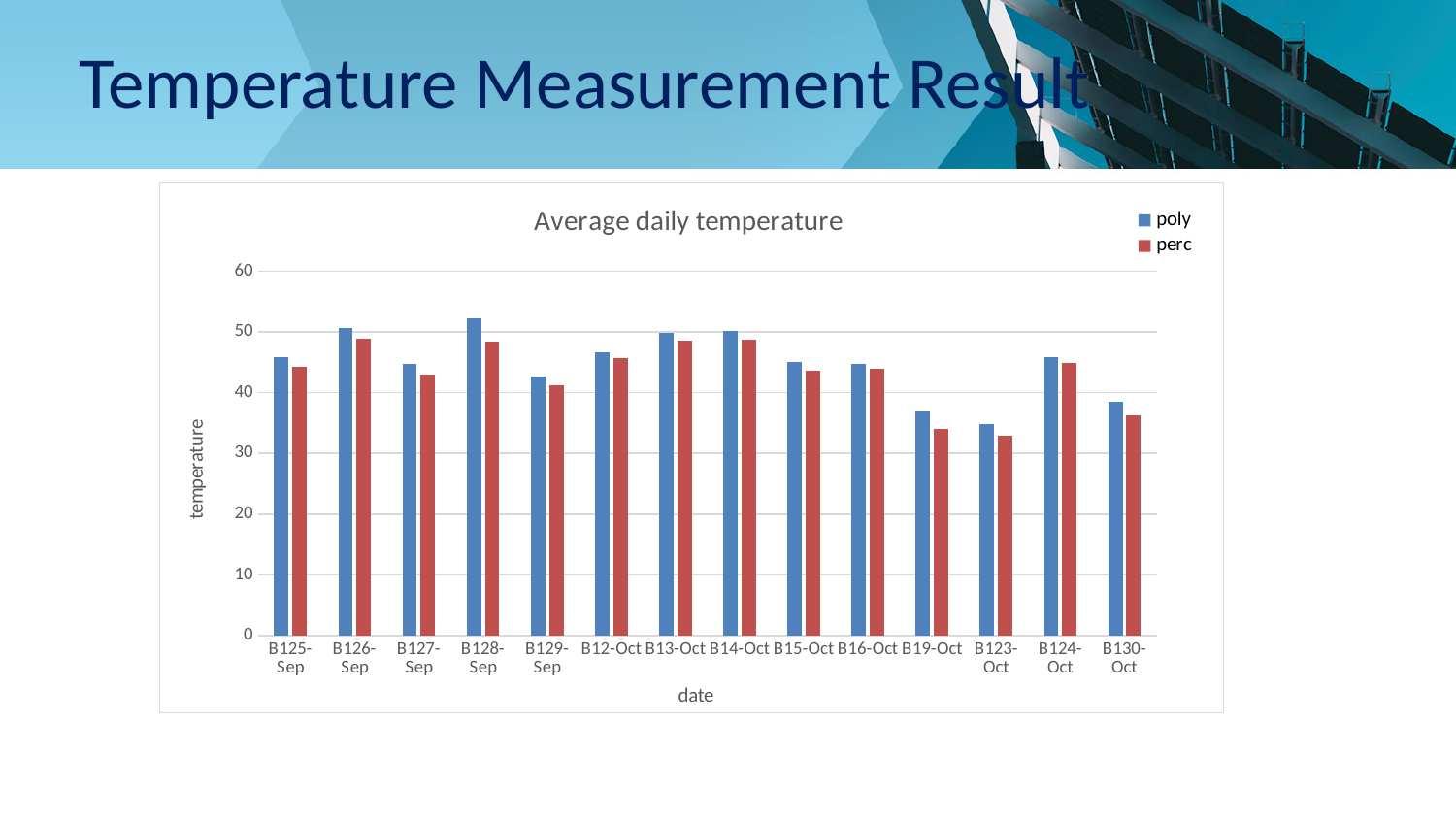
Is the poly value for B19-Oct greater or less than 40? less How many dates are shown on the x axis? 14 What kind of chart is shown on the slide? bar chart How many series does the legend list? 2 Which is larger, the perc value for B126-Sep or the perc value for B19-Oct? B126-Sep Is the perc value for B123-Oct greater or less than 40? less Which date has the lowest perc value? B123-Oct Which date has the lowest poly value? B123-Oct Which date has the highest poly value? B128-Sep Which is larger for B125-Sep, the poly value or the perc value? poly What is the title of the chart? Average daily temperature Is the poly value for B128-Sep greater or less than 50? greater